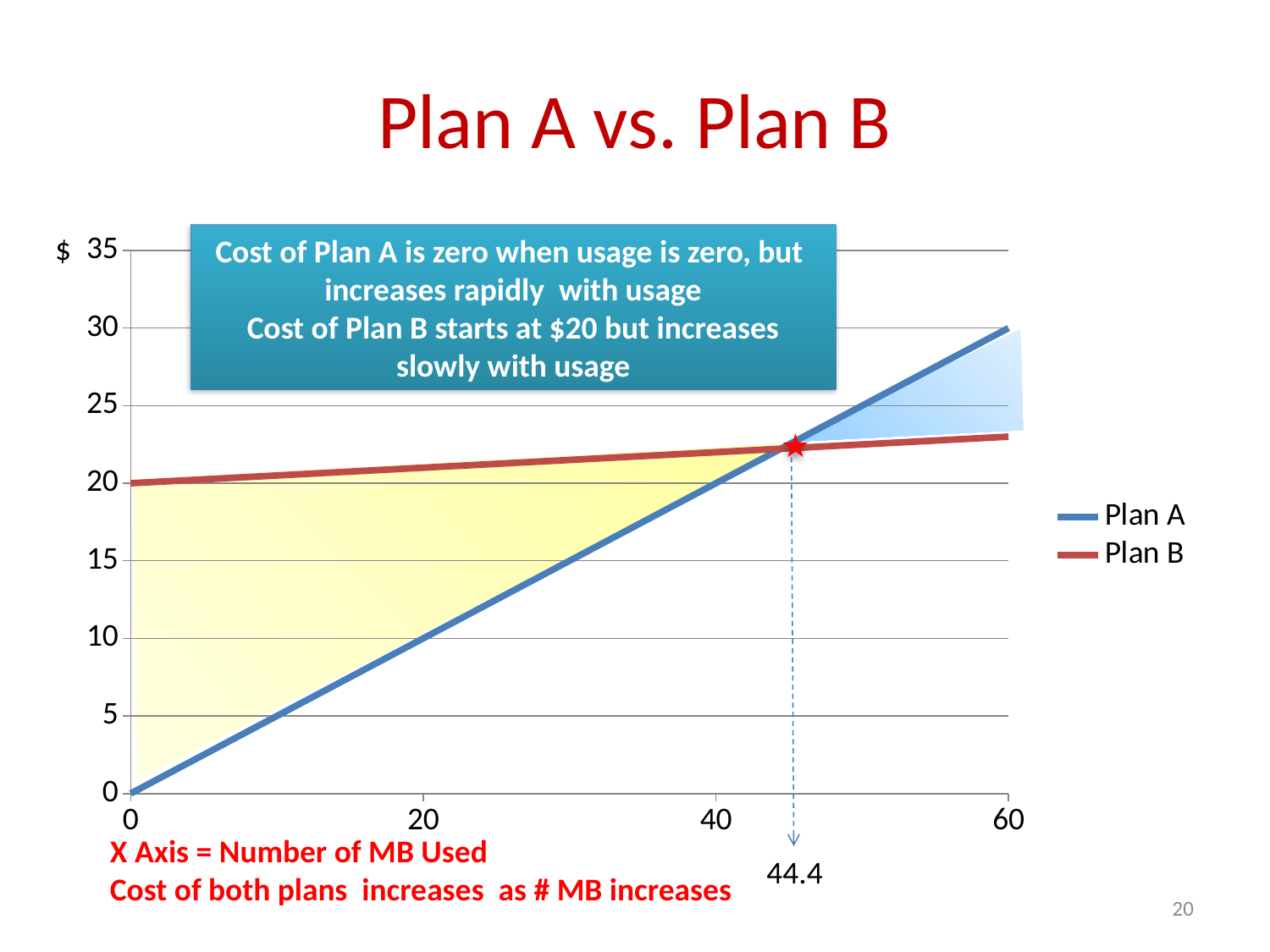
What is the title of the chart? Plan A vs. Plan B Does the cost of Plan A rise or fall as the number of MB used increases? rise Is the cost of Plan A at 40 MB greater or less than 15? greater What is the cost of Plan A when usage is 0 MB? 0 Is the cost of Plan B at 60 MB greater or less than 25? less What is the cost of Plan A at 60 MB? 30 What is the cost of Plan B when usage is 0 MB? 20 What kind of chart is shown on the slide? line chart Which plan is cheaper at 20 MB, Plan A or Plan B? Plan A How many series does the legend list? 2 Which plan is cheaper at 60 MB, Plan A or Plan B? Plan B At how many MB do the Plan A and Plan B lines intersect? 44.4